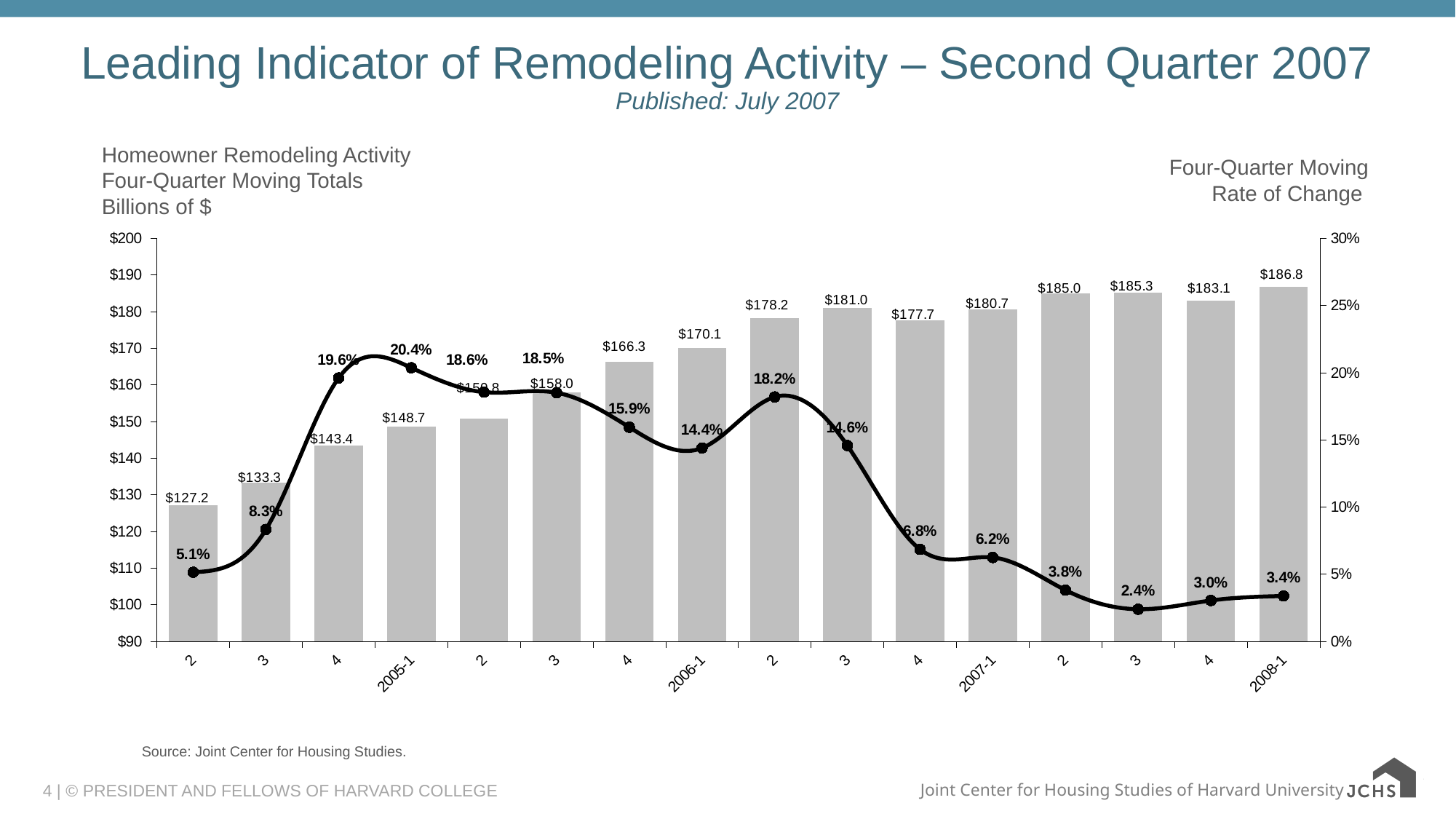
What is the lowest four-quarter moving rate of change shown on the chart? 2.4% How many quarters are plotted on the x axis? 16 What is the four-quarter moving rate of change for 2007-1? 6.2% What is the four-quarter moving total (billions of $) for 2008-1? $186.8 Which is larger, the four-quarter moving total for 2006-1 or for 2007-1? 2007-1 Which quarter has the highest four-quarter moving total? 2008-1 What is the lowest four-quarter moving total shown on the chart? $127.2 Which quarter has the highest four-quarter moving rate of change? 2005-1 What kind of chart is this? Combination bar and line chart What is the four-quarter moving rate of change for 2005-1? 20.4% How much higher is the four-quarter moving total for 2008-1 than for 2007-1? $6.1 What is the four-quarter moving total for 2006-1? $170.1